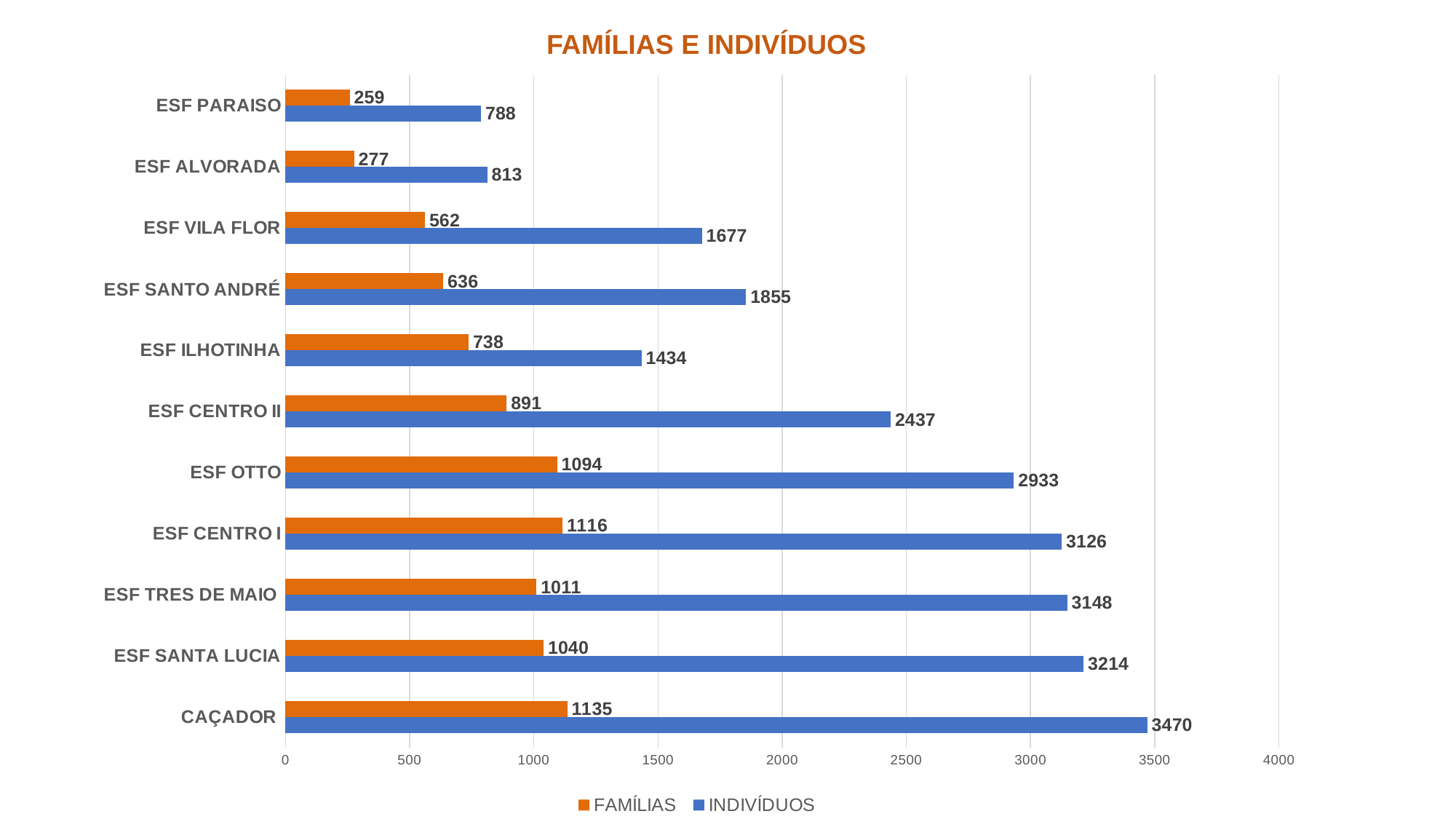
What is the FAMÍLIAS value for ESF VILA FLOR? 562 What is the difference between the INDIVÍDUOS values for ESF SANTA LUCIA and ESF TRES DE MAIO? 66 How many categories are shown on the chart? 11 Which category has the highest INDIVÍDUOS value? CAÇADOR Which colour represents the INDIVÍDUOS series? blue How many series does the legend list? 2 What kind of chart is shown on the slide? bar chart Is the INDIVÍDUOS value for ESF ILHOTINHA greater or less than 1500? less What is the title of the chart? FAMÍLIAS E INDIVÍDUOS Which category has the lowest FAMÍLIAS value? ESF PARAISO Which is larger, the FAMÍLIAS value for ESF OTTO or for ESF SANTA LUCIA? ESF OTTO What is the INDIVÍDUOS value for ESF CENTRO II? 2437